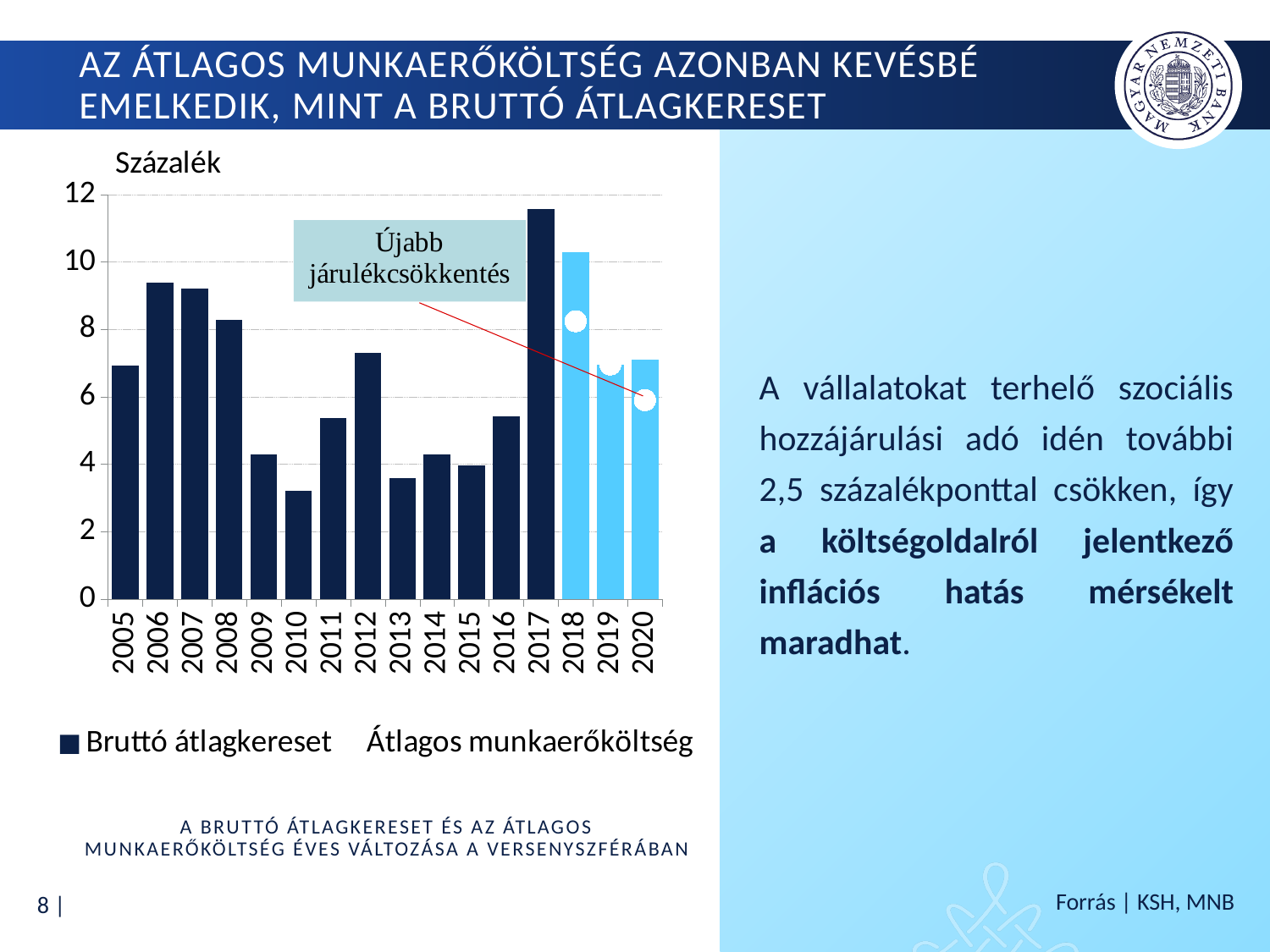
Which bar is taller, 2008 or 2012? 2008 Which year has the lowest bar in the chart? 2010 What unit label is shown above the vertical axis of the chart? Százalék How many years are shown on the x axis of the chart? 16 What kind of chart is shown on the slide? bar chart Is the bar for 2017 greater or less than 10? greater Is the bar for 2010 greater or less than 4? less Which year has the highest bar in the chart? 2017 How many series does the chart legend list? 2 From 2006 to 2010, do the bars rise or fall? fall Is the bar for 2006 greater or less than 8? greater